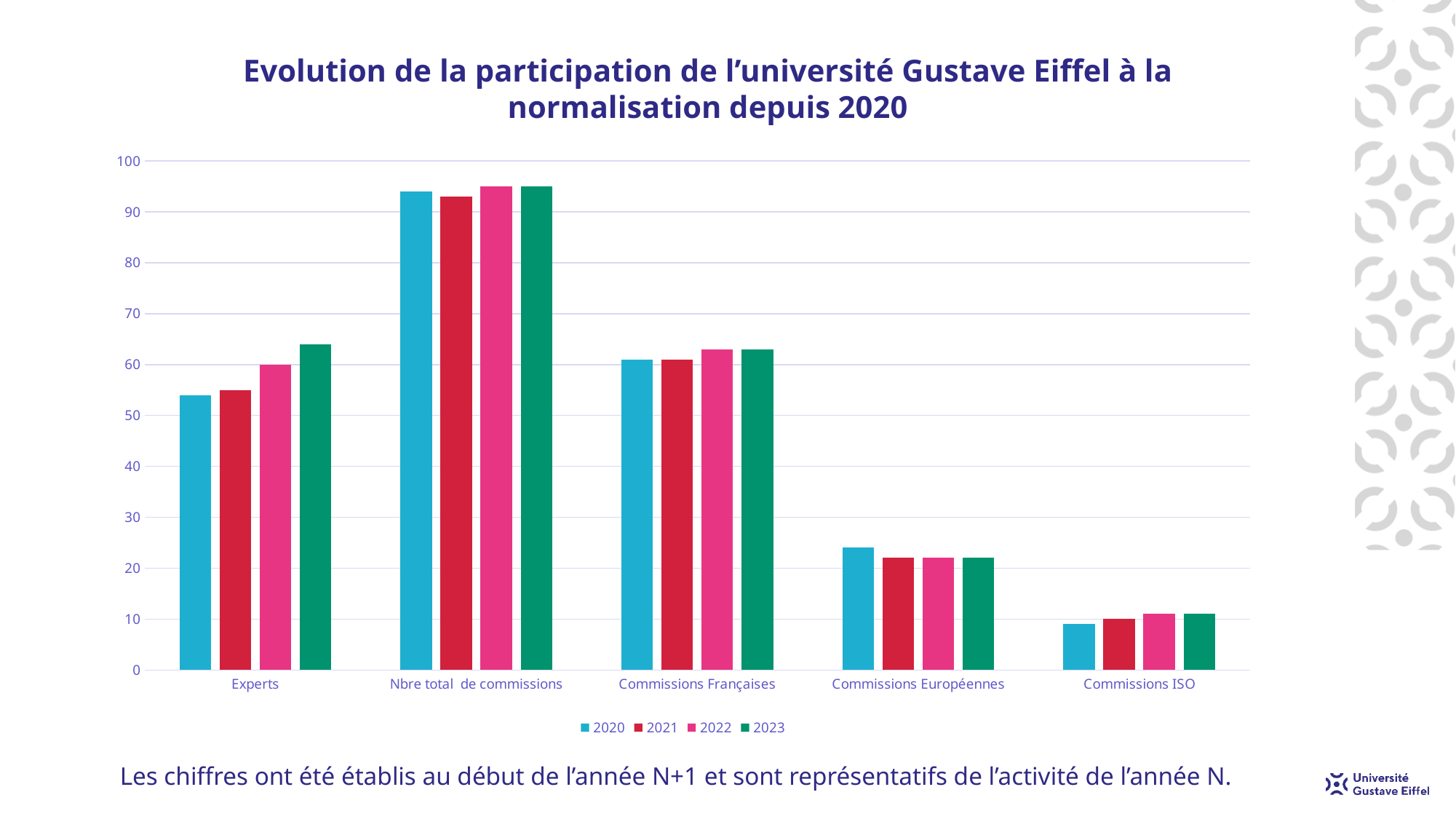
For Experts, which year has the larger value, 2020 or 2023? 2023 Which category has the highest bars in the chart? Nbre total de commissions What years are listed in the chart legend? 2020, 2021, 2022, 2023 Is the value for Experts in 2020 greater or less than 60? less How many series does the chart legend list? 4 Which category has the lowest bars in the chart? Commissions ISO For the Experts category, do the values rise or fall from 2020 to 2023? rise How many categories are shown on the x axis of the chart? 5 Is the value for Commissions Européennes in 2020 greater or less than 20? greater Is the value for Nbre total de commissions in 2020 greater or less than 90? greater What kind of chart is shown on the slide? bar chart